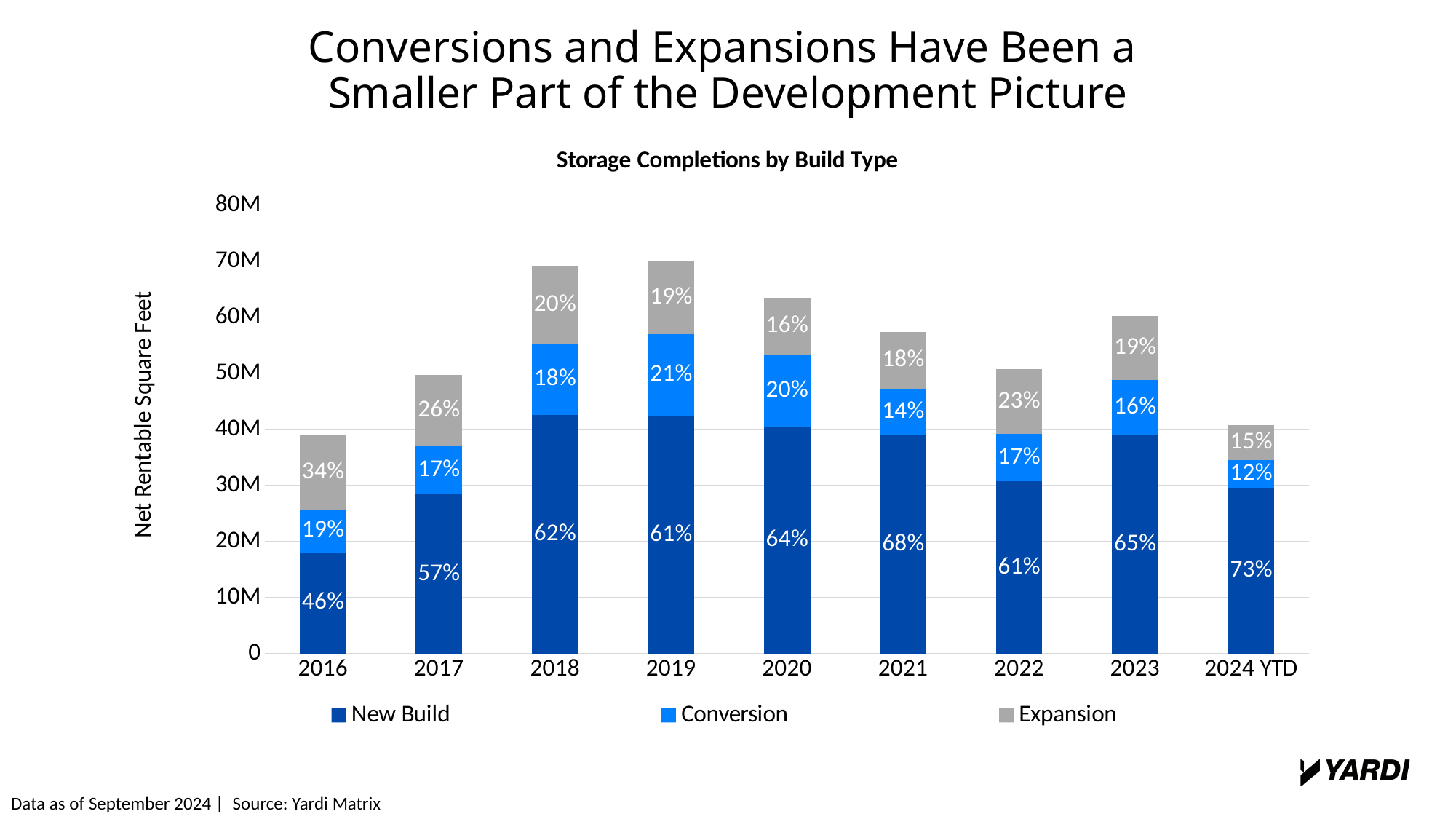
How many series does the legend list? 3 How many years (categories) are shown on the x axis? 9 What kind of chart is shown on the slide? Stacked bar chart Which year has the lowest New Build percentage? 2016 Which year had a larger Expansion percentage, 2017 or 2022? 2017 Is the total completions value for 2024 YTD greater or less than 50M? less Which year has the highest New Build percentage? 2024 YTD What percentage of completions in 2016 was Expansion? 34% What percentage of completions in 2024 YTD was New Build? 73% Is the total completions value for 2019 greater or less than 60M? greater What is the chart's title? Storage Completions by Build Type What percentage of completions in 2019 was Conversion? 21%